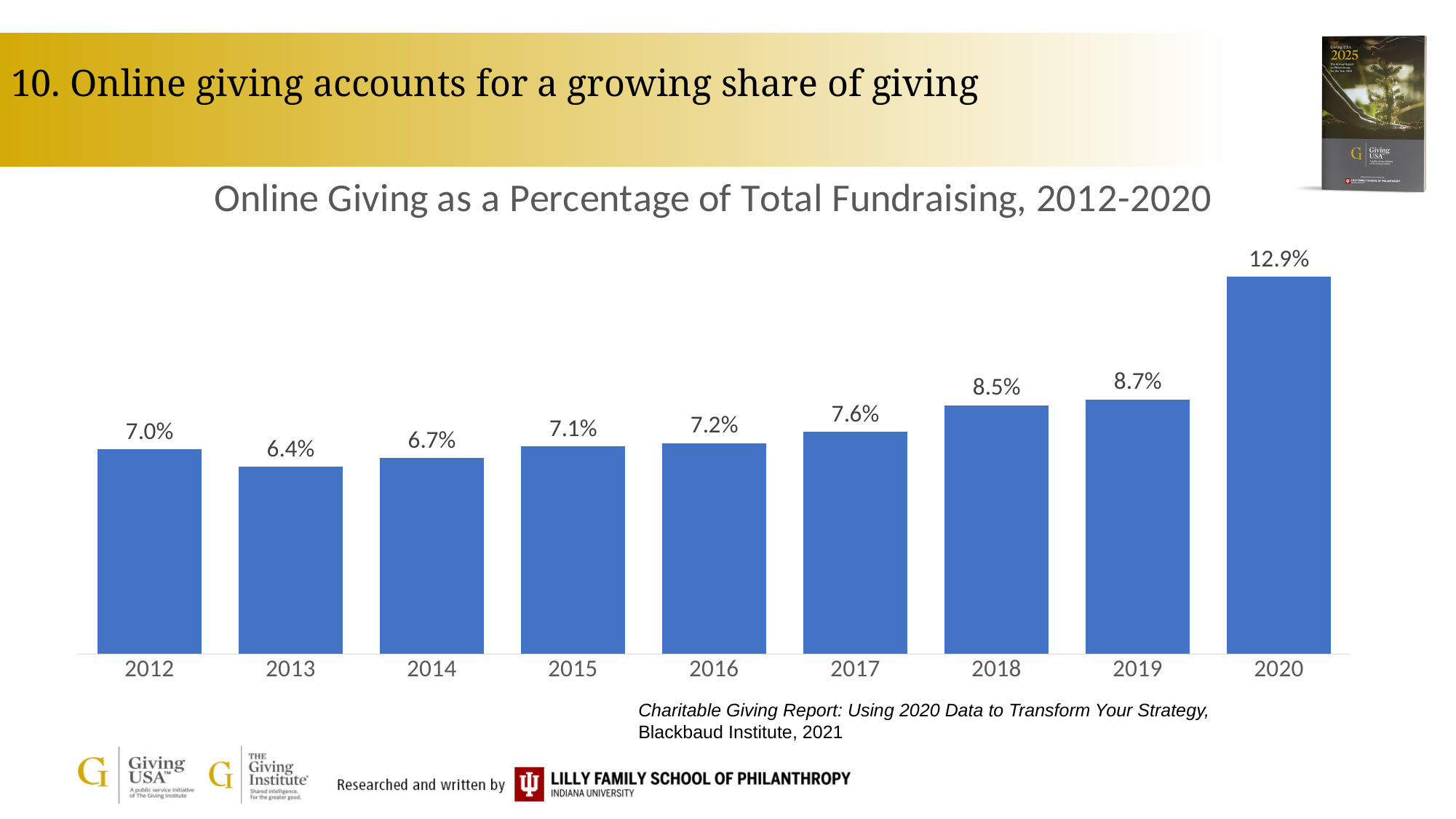
How many years are shown on the chart? 9 Which is larger, the value for 2014 or the value for 2018? 2018 What is the value for 2017? 7.6% What kind of chart is this? Bar chart What is the value for 2020? 12.9% Which year has the highest value? 2020 Which year has the lowest value? 2013 What is the title of the chart? Online Giving as a Percentage of Total Fundraising, 2012-2020 What is the value for 2013? 6.4% What is the difference between the values for 2020 and 2019? 4.2% What is the difference between the values for 2012 and 2013? 0.6% Do the values generally rise or fall from 2013 to 2020? Rise